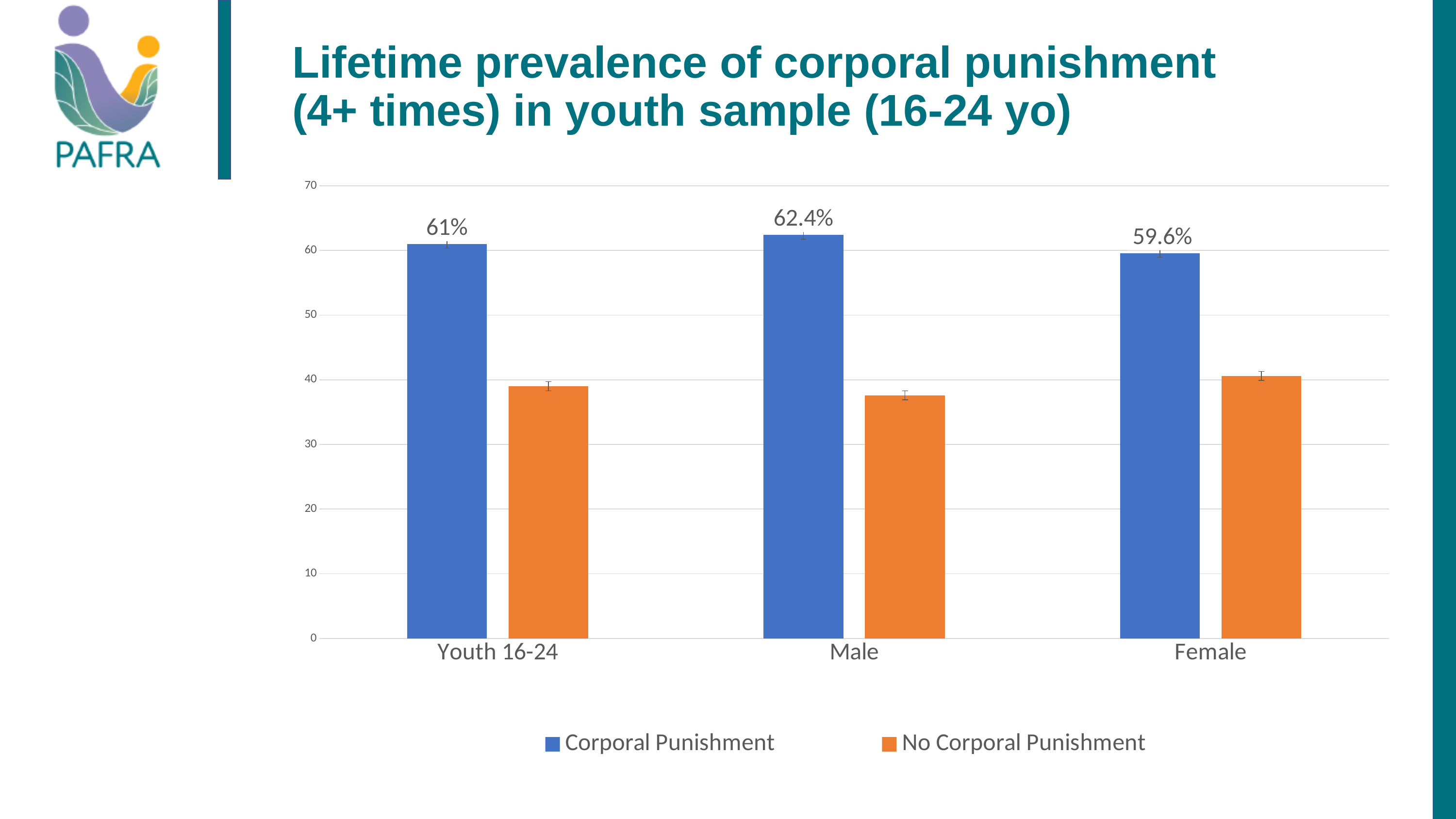
What is the Corporal Punishment value for Female? 59.6% What kind of chart is shown on the slide? bar chart How many series does the legend list? 2 Is the No Corporal Punishment value for Female greater or less than 30? greater Which category has the highest Corporal Punishment value? Male Is the No Corporal Punishment value for Male greater or less than 40? less What is the Corporal Punishment value for Youth 16-24? 61% What is the Corporal Punishment value for Male? 62.4% Which category has the lowest Corporal Punishment value? Female How many categories are shown on the x axis? 3 What is the difference between the Corporal Punishment values for Male and Female? 2.8% Which is larger, the Corporal Punishment value for Male or for Youth 16-24? Male